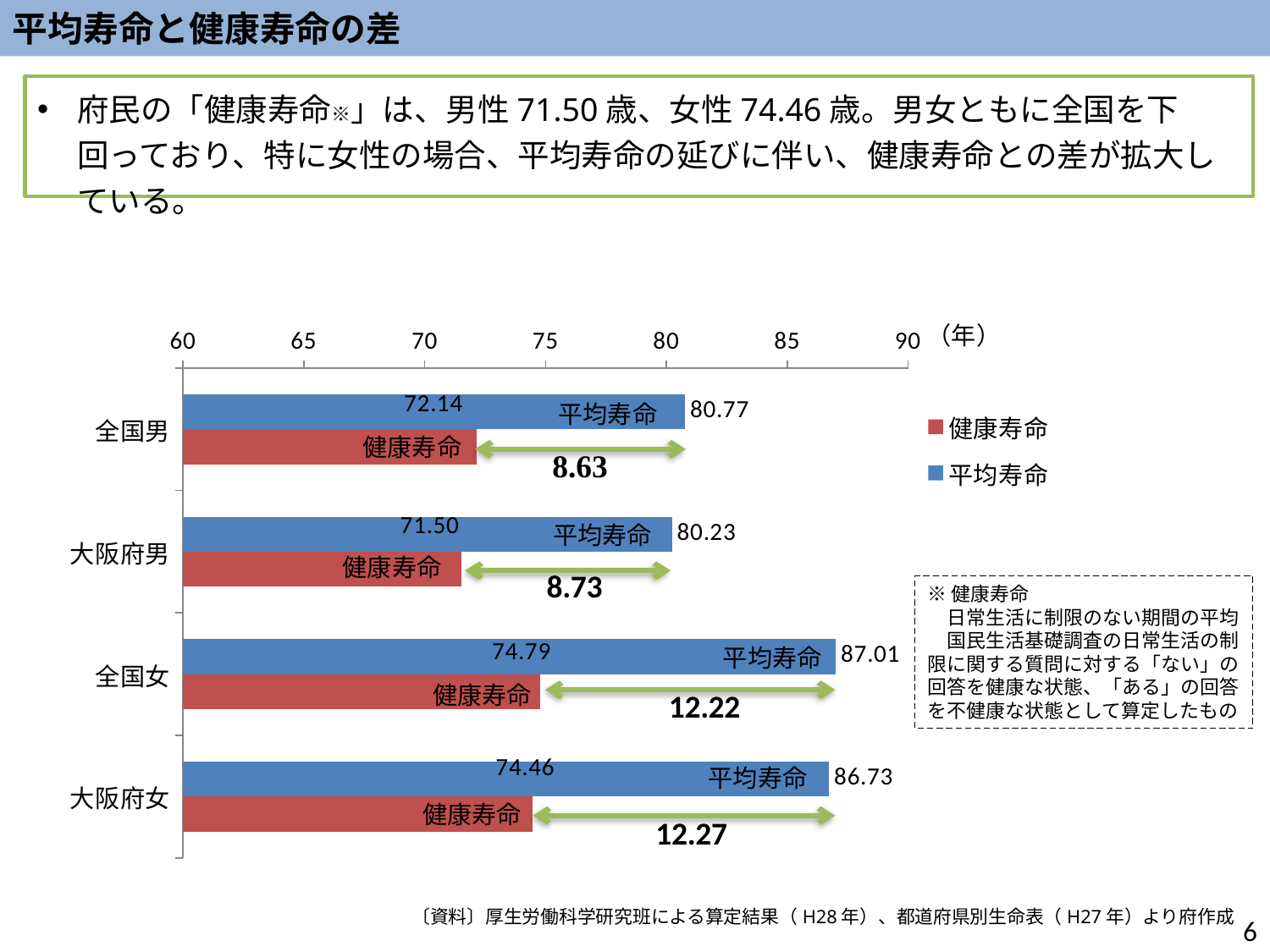
Which is larger, the 健康寿命 for 全国女 or the 健康寿命 for 大阪府女? 全国女 What is the difference between 平均寿命 and 健康寿命 for 全国男? 8.63 What is the 平均寿命 value for 全国女? 87.01 Which category has the highest 平均寿命 value? 全国女 How many categories are shown on the chart? 4 What kind of chart is shown on the slide? bar chart What is the 健康寿命 value for 大阪府男? 71.50 What is the 平均寿命 value for 大阪府女? 86.73 What is the 健康寿命 value for 全国男? 72.14 How many series does the legend list? 2 What is the difference between 平均寿命 and 健康寿命 for 大阪府女? 12.27 Which category has the lowest 健康寿命 value? 大阪府男